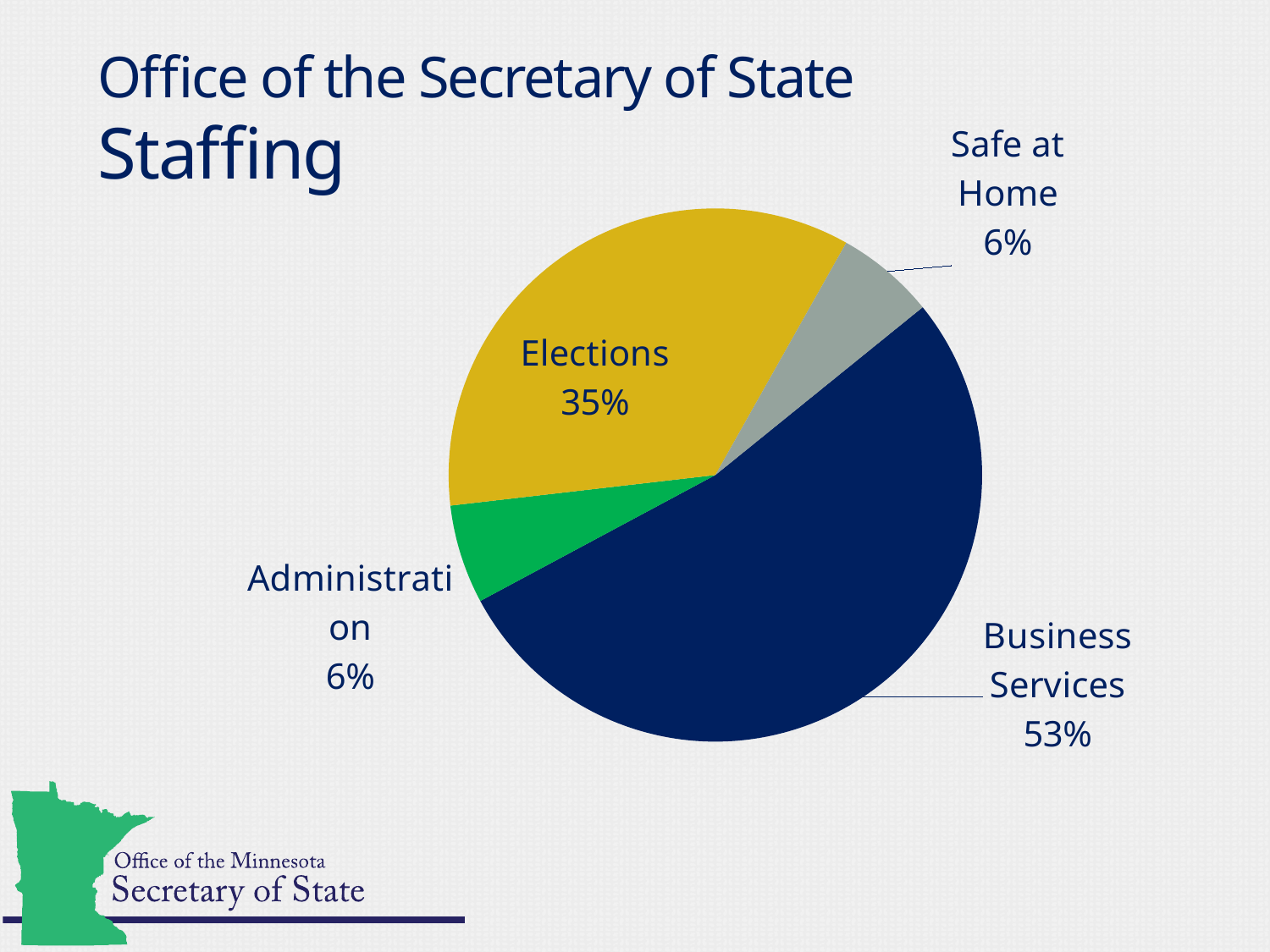
Which has a larger share of staffing, Elections or Business Services? Business Services What share of staffing does Elections account for? 35% How many slices does the pie chart have? 4 What is the combined share of Business Services and Elections? 88% What colour is the Elections slice? Yellow What is the difference in percentage points between Elections and Administration? 29 What kind of chart is shown on the slide? Pie chart Which division has the largest share of staffing? Business Services What share of staffing does Safe at Home account for? 6% What share of staffing does Business Services account for? 53% What share of staffing does Administration account for? 6% What is the difference in percentage points between Business Services and Elections? 18